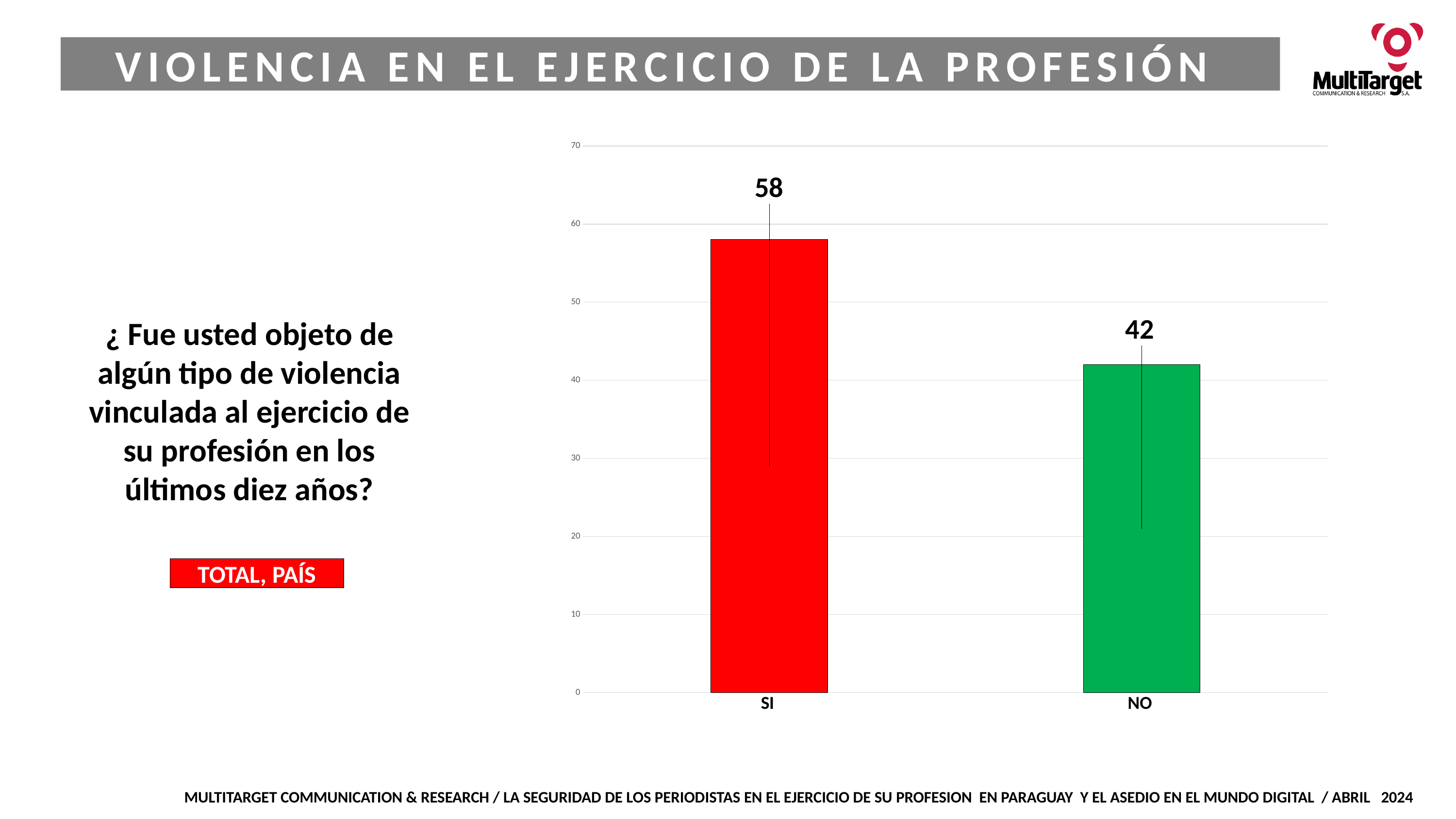
What is the value for SI? 58 What kind of chart is shown on the slide? bar chart Which category has the highest value? SI What colour is the bar for SI? red What is the highest value shown on the vertical axis? 70 What is the value for NO? 42 Is the value for SI greater or less than 50? greater Which category has the lowest value? NO What is the difference between the values for SI and NO? 16 Which is larger, the value for SI or the value for NO? SI How many categories are shown on the x axis? 2 Is the value for NO greater or less than 50? less